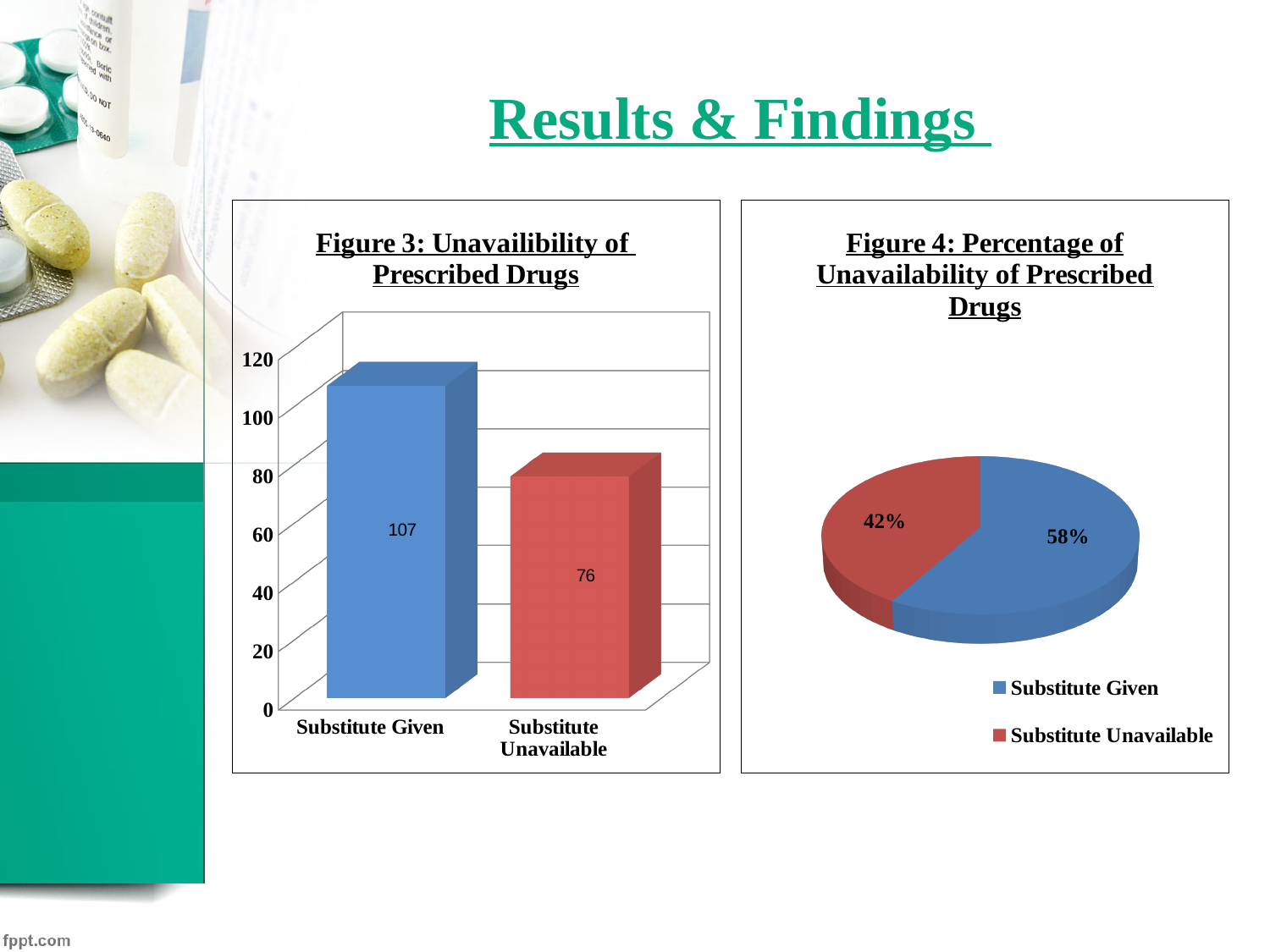
In Figure 4, which slice is larger, Substitute Given or Substitute Unavailable? Substitute Given In Figure 3, what is the value for Substitute Unavailable? 76 In Figure 3, which category has the highest value? Substitute Given In Figure 3, is the value for Substitute Unavailable greater or less than 80? less What kind of chart is Figure 3? bar chart In Figure 4, what share of the pie is Substitute Unavailable? 42% In Figure 3, what is the difference between the values for Substitute Given and Substitute Unavailable? 31 In Figure 3, which category has the lowest value? Substitute Unavailable In Figure 3, how many categories are shown on the x axis? 2 In Figure 4, how many entries does the legend list? 2 In Figure 4, what share of the pie is Substitute Given? 58% In Figure 3, what is the value for Substitute Given? 107